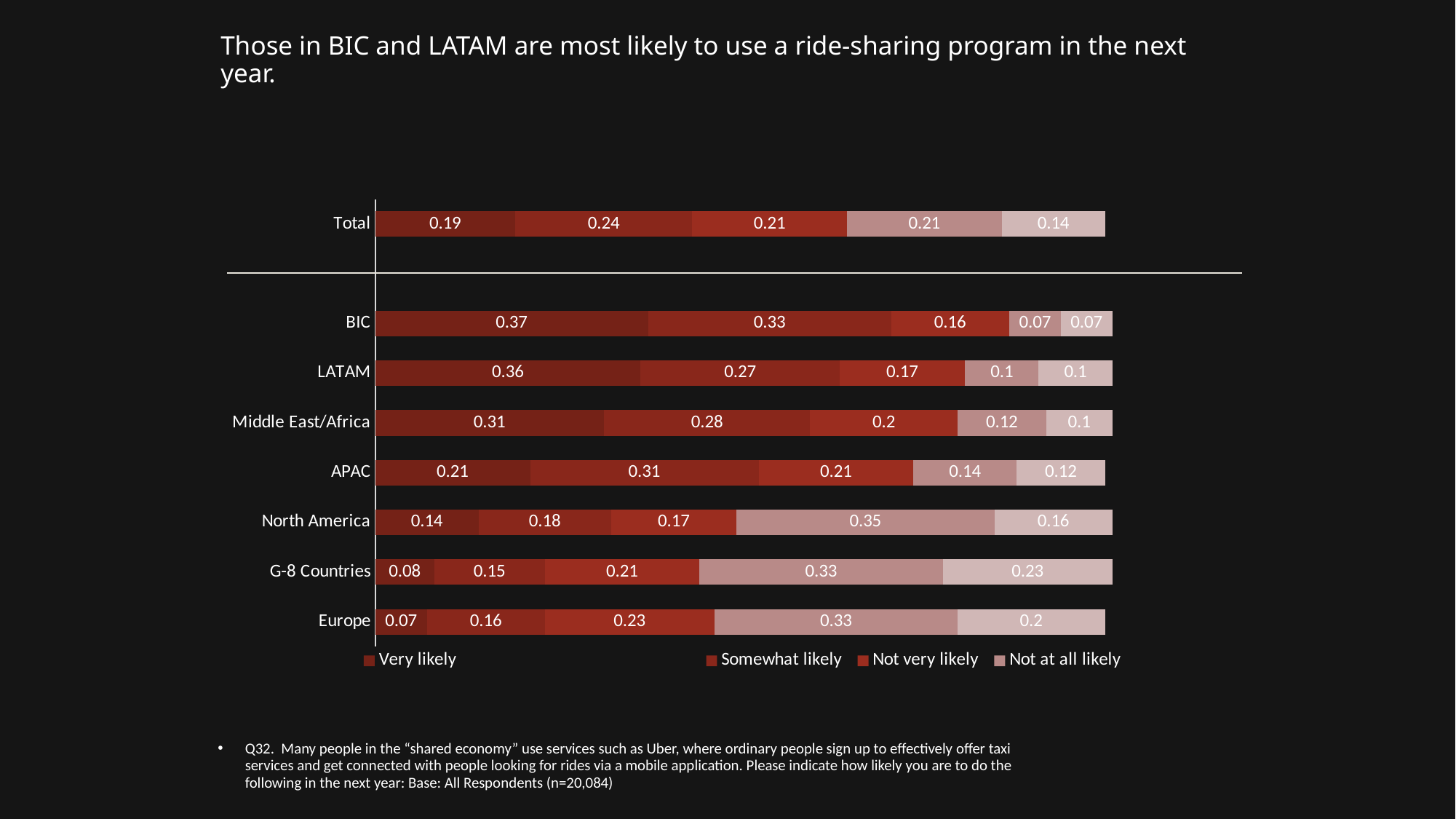
What is the Somewhat likely value for APAC? 0.31 Which has the larger Somewhat likely value, LATAM or Middle East/Africa? Middle East/Africa Which region has the highest Very likely value? BIC What is the Very likely value for Europe? 0.07 Which region has the lowest Very likely value? Europe What is the Not very likely value for North America? 0.17 What is the difference between the Very likely values for BIC and Europe? 0.3 How many bars (categories) are shown in the chart, including Total? 8 What is the Very likely value for Total? 0.19 What kind of chart is shown on the slide? Stacked bar chart What is the title of the slide? Those in BIC and LATAM are most likely to use a ride-sharing program in the next year. What is the Very likely value for BIC? 0.37